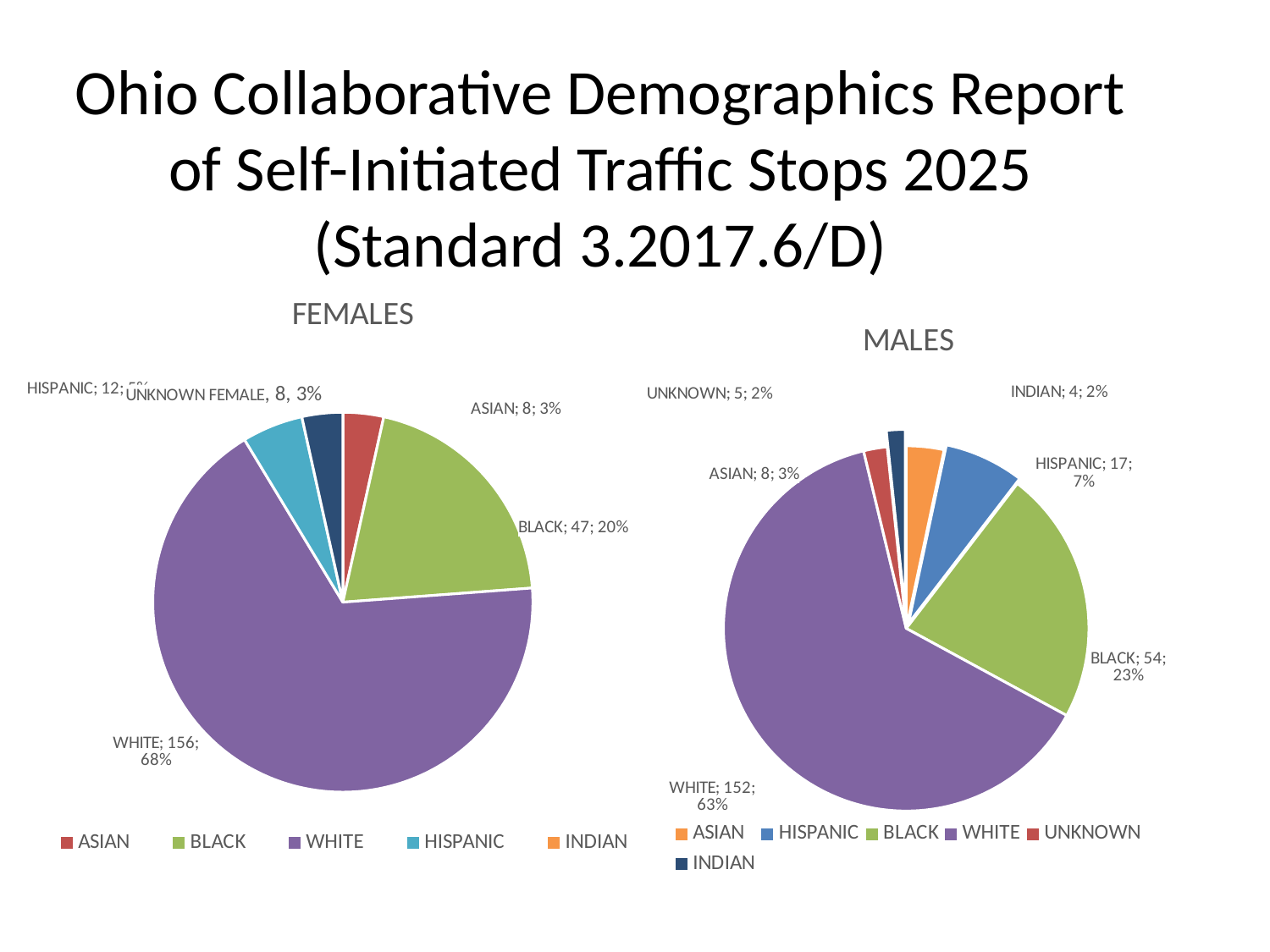
What kind of chart is used on this slide? Pie chart How many entries does the legend of the MALES chart list? 6 In the FEMALES pie chart, what share of the pie is WHITE? 68% What is the title of the chart on the left side of the slide? FEMALES In the MALES pie chart, what is the difference between the WHITE and BLACK values? 98 In the MALES pie chart, what share of the pie is HISPANIC? 7% In the MALES pie chart, which category has the largest slice? WHITE In the FEMALES pie chart, what is the value for BLACK? 47 In the MALES pie chart, what share of the pie is BLACK? 23% In the MALES pie chart, what is the value for WHITE? 152 In the MALES pie chart, which category has the smallest value? INDIAN Which chart shows a larger value for HISPANIC, FEMALES or MALES? MALES